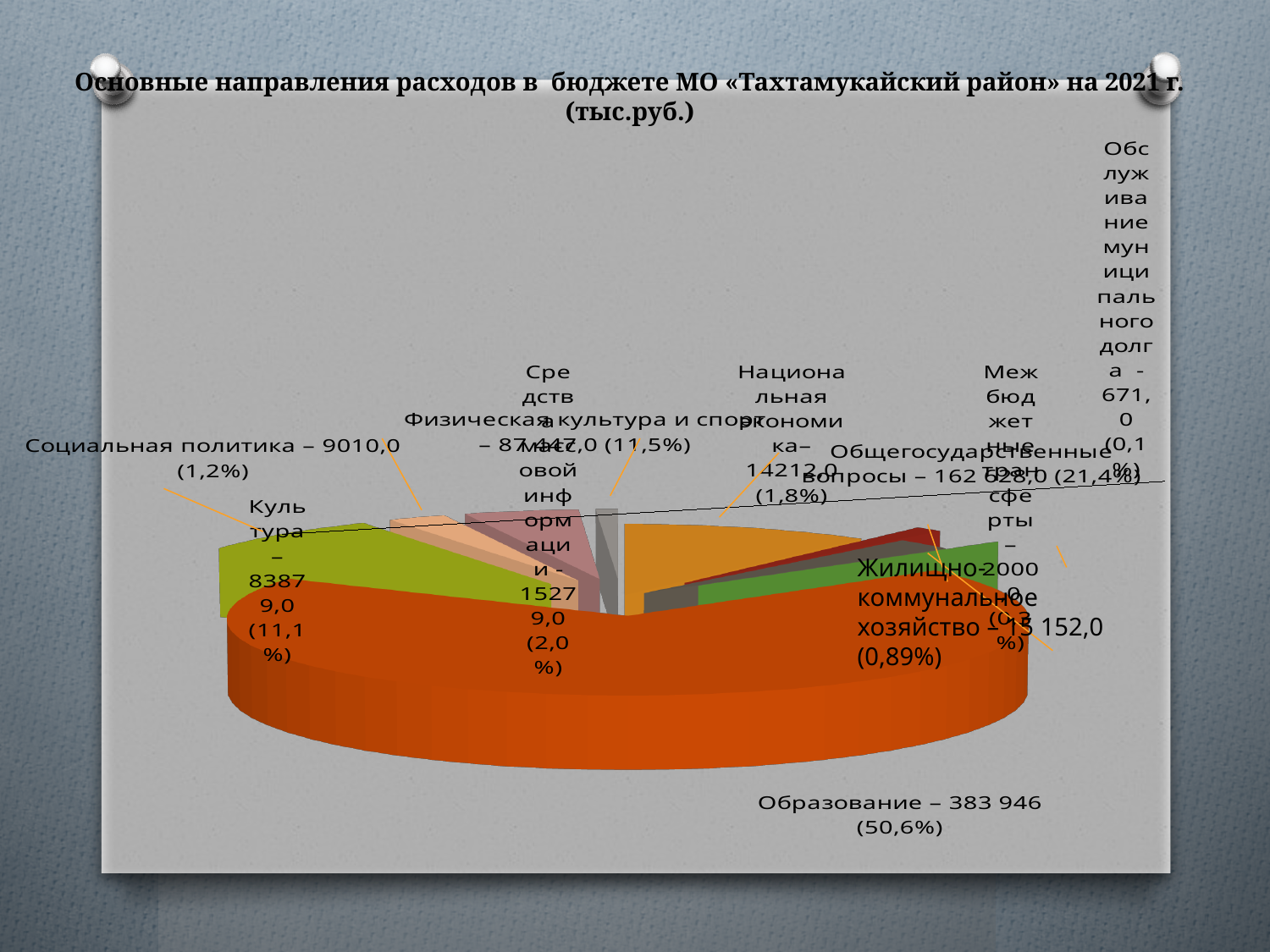
Which expenditure category has the largest share of the pie? Образование What kind of chart is shown on the slide? pie chart Which is larger, the value for Культура or the value for Социальная политика? Культура Which expenditure category has the smallest share of the pie? Обслуживание муниципального долга What share of the pie does Образование account for? 50,6% What share of the pie does Культура account for? 11,1% What is the value shown for Социальная политика? 9010,0 What is the value shown for Жилищно-коммунальное хозяйство? 13 152,0 What is the value shown for Образование? 383 946 How many expenditure categories are shown in the pie chart? 10 What share of the pie does Общегосударственные вопросы account for? 21,4% What is the value shown for Общегосударственные вопросы? 162 628,0